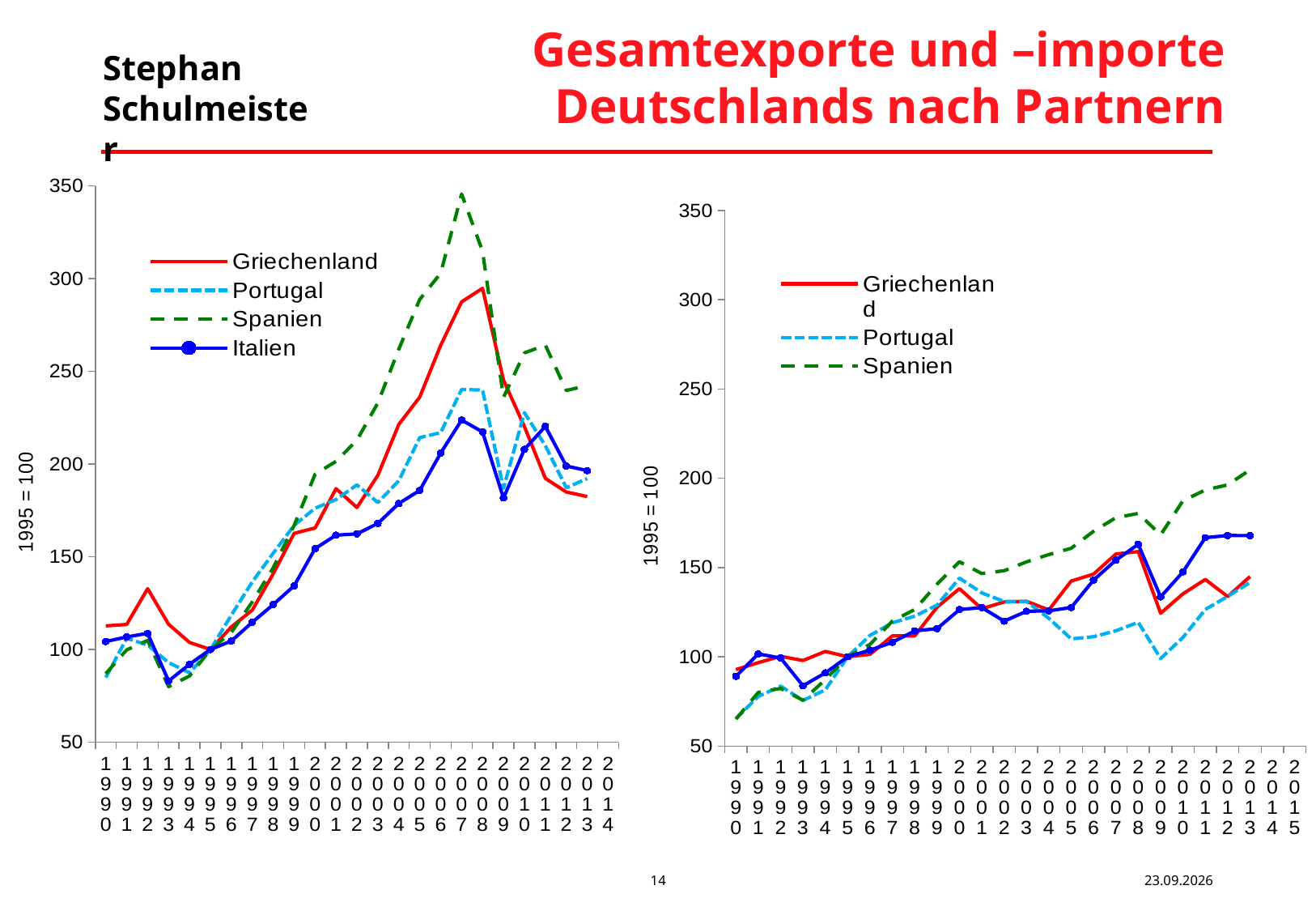
How many series does the legend of the right chart list? 3 In the right chart, is the value for Portugal in 2005 greater or less than 150? less In the left chart, does the Griechenland line generally rise or fall between 1995 and 2008? rise In the left chart, which series has the higher value in 2007, Spanien or Griechenland? Spanien In the left chart, is the value for Italien in 2009 greater or less than 200? less What is the y-axis label of the left chart? 1995 = 100 How many series does the legend of the left chart list? 4 In the right chart, is the value for Spanien in 2008 greater or less than 150? greater In the right chart, which series has the higher value in 2012, Spanien or Portugal? Spanien What type of chart is the left chart on the slide? line chart